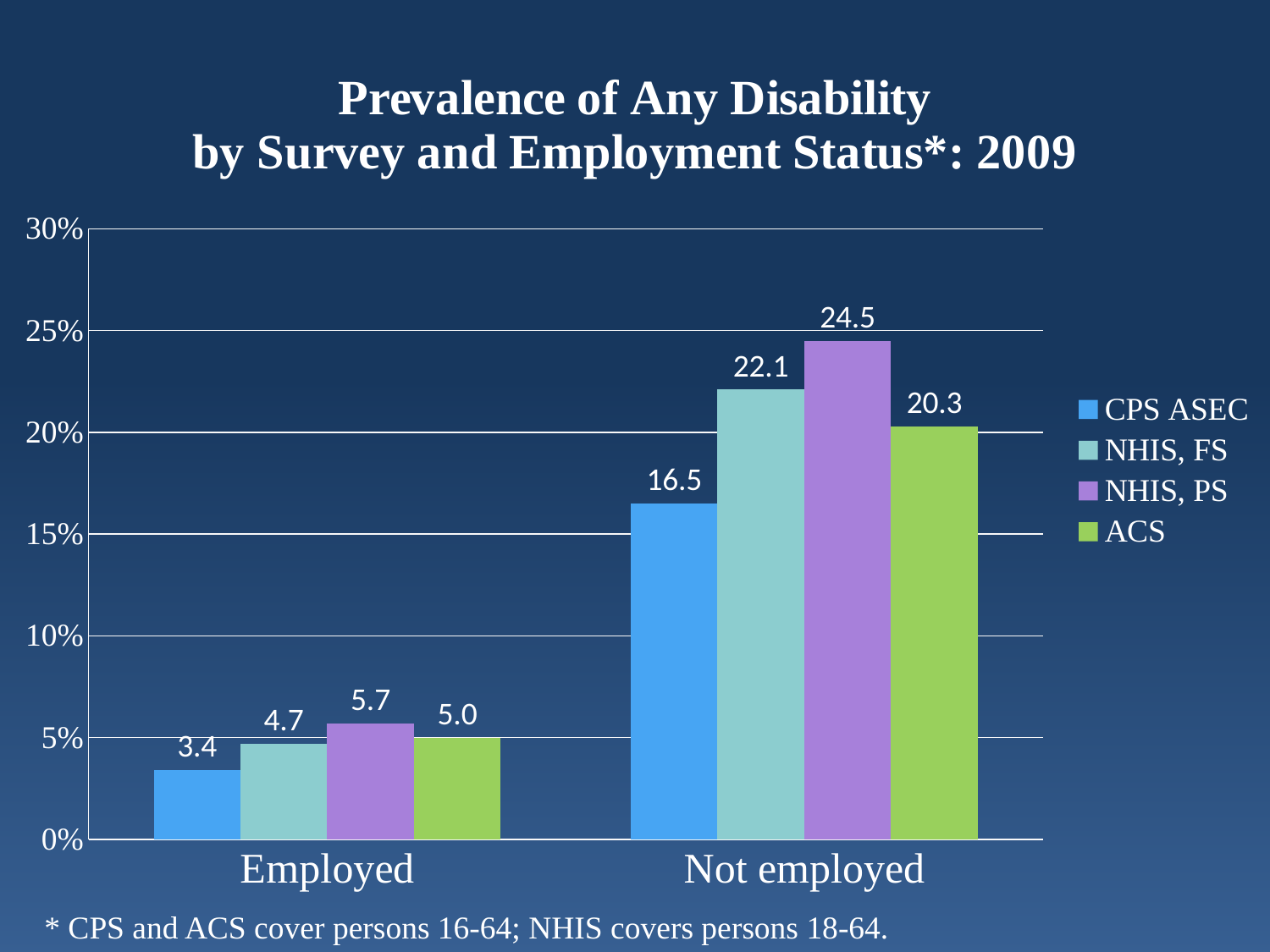
What kind of chart is shown on the slide? Bar chart How many series does the legend list? 4 Which survey has the highest value in the Not employed category? NHIS, PS What is the value for ACS in the Not employed category? 20.3 What is the title of the chart? Prevalence of Any Disability by Survey and Employment Status*: 2009 Is the CPS ASEC value for Not employed greater or less than 15%? greater Which survey has the lowest value in the Employed category? CPS ASEC What is the value for NHIS, PS in the Not employed category? 24.5 What is the difference between the NHIS, FS values for Not employed and Employed? 17.4 What is the value for CPS ASEC in the Employed category? 3.4 How many employment status categories are shown on the x axis? 2 Which is larger: the ACS value for Employed or the NHIS, PS value for Employed? NHIS, PS